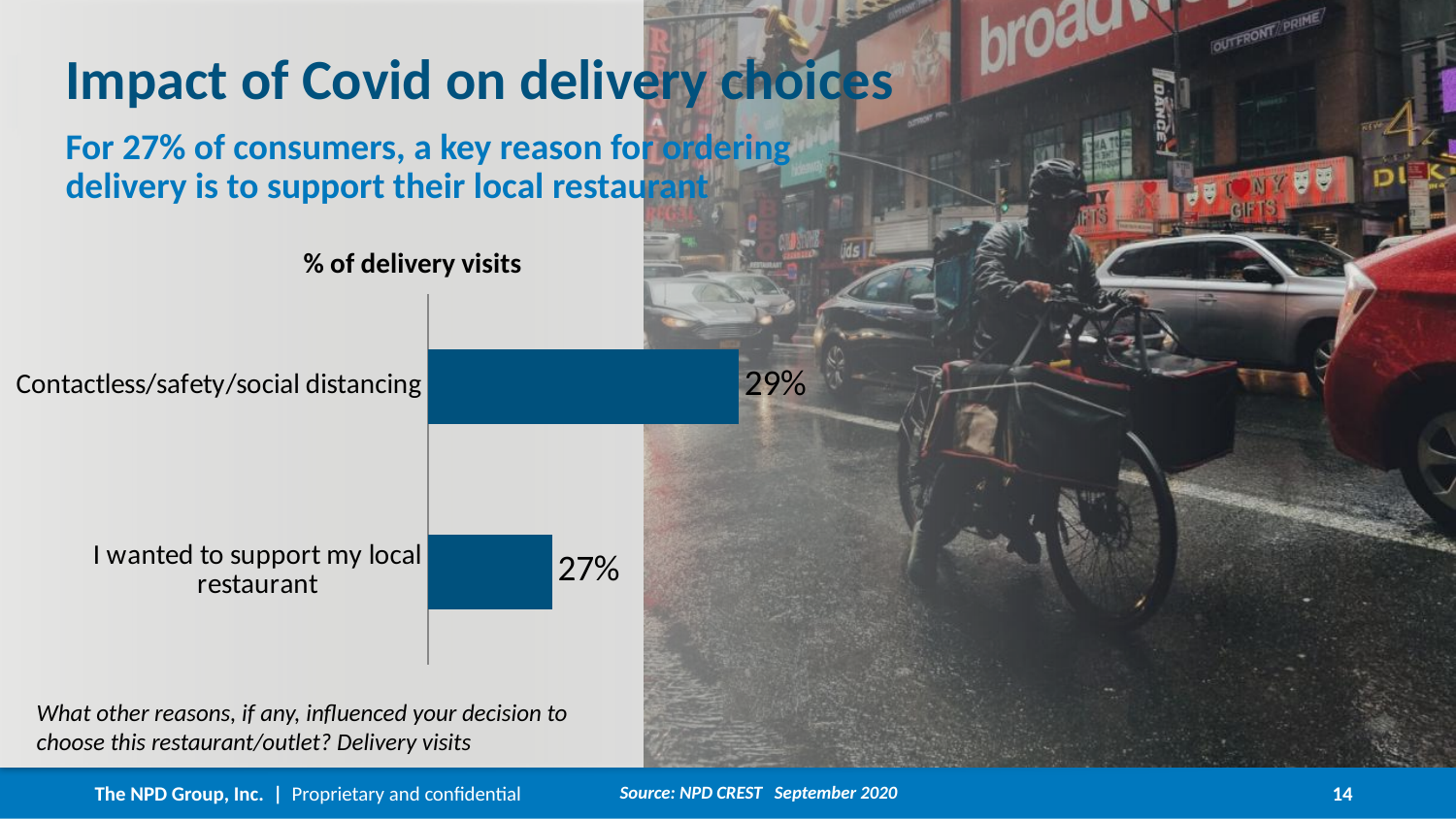
What kind of chart is shown on the slide? Bar chart How many categories are shown in the chart? 2 Which category has the lowest value? I wanted to support my local restaurant What is the value for 'I wanted to support my local restaurant'? 27% Which category has the highest value? Contactless/safety/social distancing What is the difference between the value for Contactless/safety/social distancing and the value for 'I wanted to support my local restaurant'? 2% Which is larger: the value for Contactless/safety/social distancing or the value for 'I wanted to support my local restaurant'? Contactless/safety/social distancing What is the title of the chart? % of delivery visits What is the value for Contactless/safety/social distancing? 29% What colour are the bars in the chart? Blue